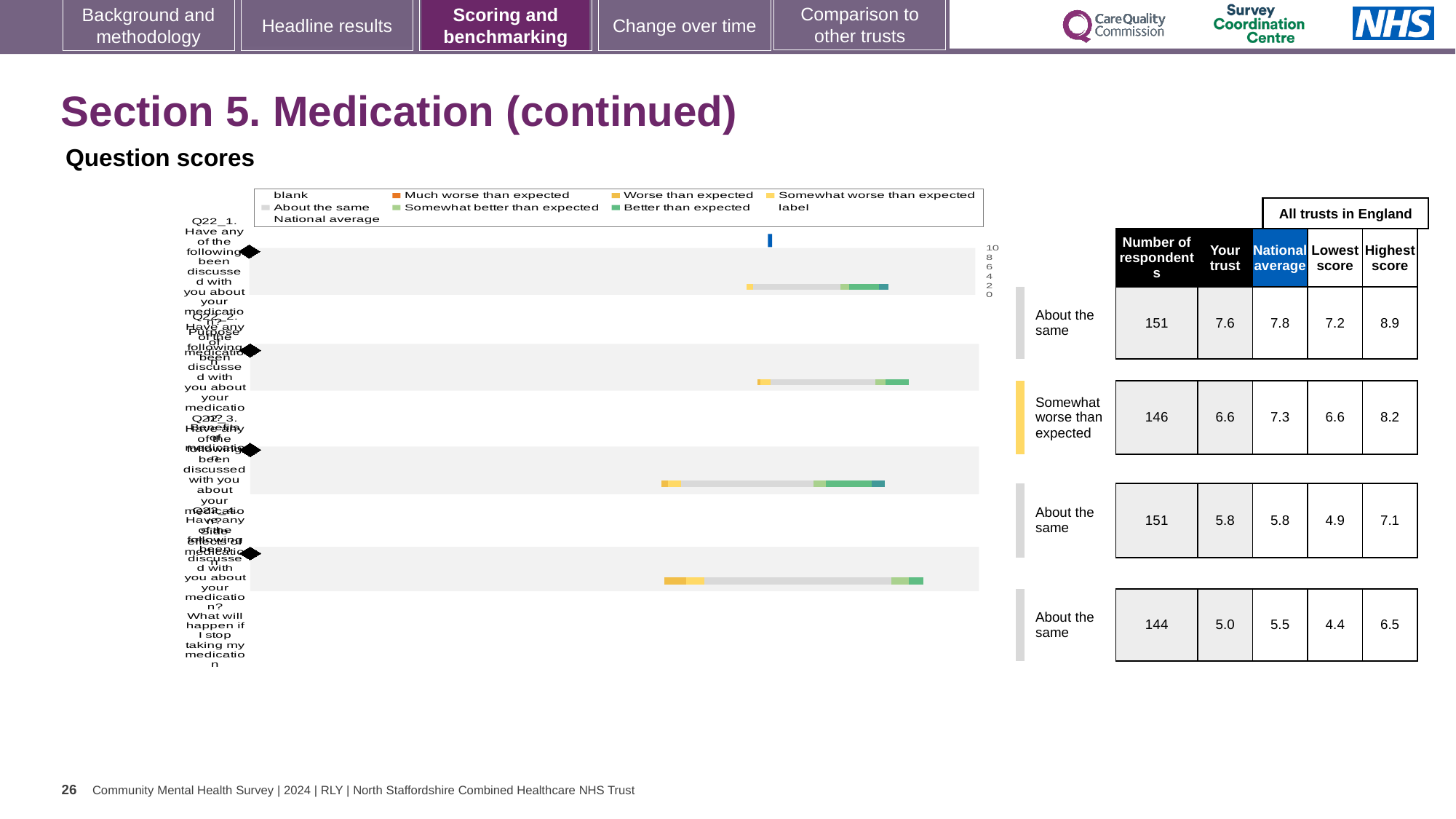
Is the 'Your trust' score or the national average larger for the fourth question row (Q22_4)? National average How many question rows (bars) are plotted in the chart? 4 Which benchmark category does the second question row (Q22_2) fall into? Somewhat worse than expected What colour is the 'Somewhat worse than expected' legend entry? yellow What is the difference between the national average and the 'Your trust' score for the second question row (Q22_2)? 0.7 Which question row has the highest 'Your trust' score? Q22_1 What is the national average for the second question row (Q22_2)? 7.3 What is the 'Your trust' score for the first question row (Q22_1)? 7.6 What is the highest score among all trusts in England for the third question row (Q22_3)? 7.1 Which question row has the lowest 'Your trust' score? Q22_4 What is the number of respondents for the fourth question row (Q22_4)? 144 What kind of chart is shown under 'Question scores'? bar chart